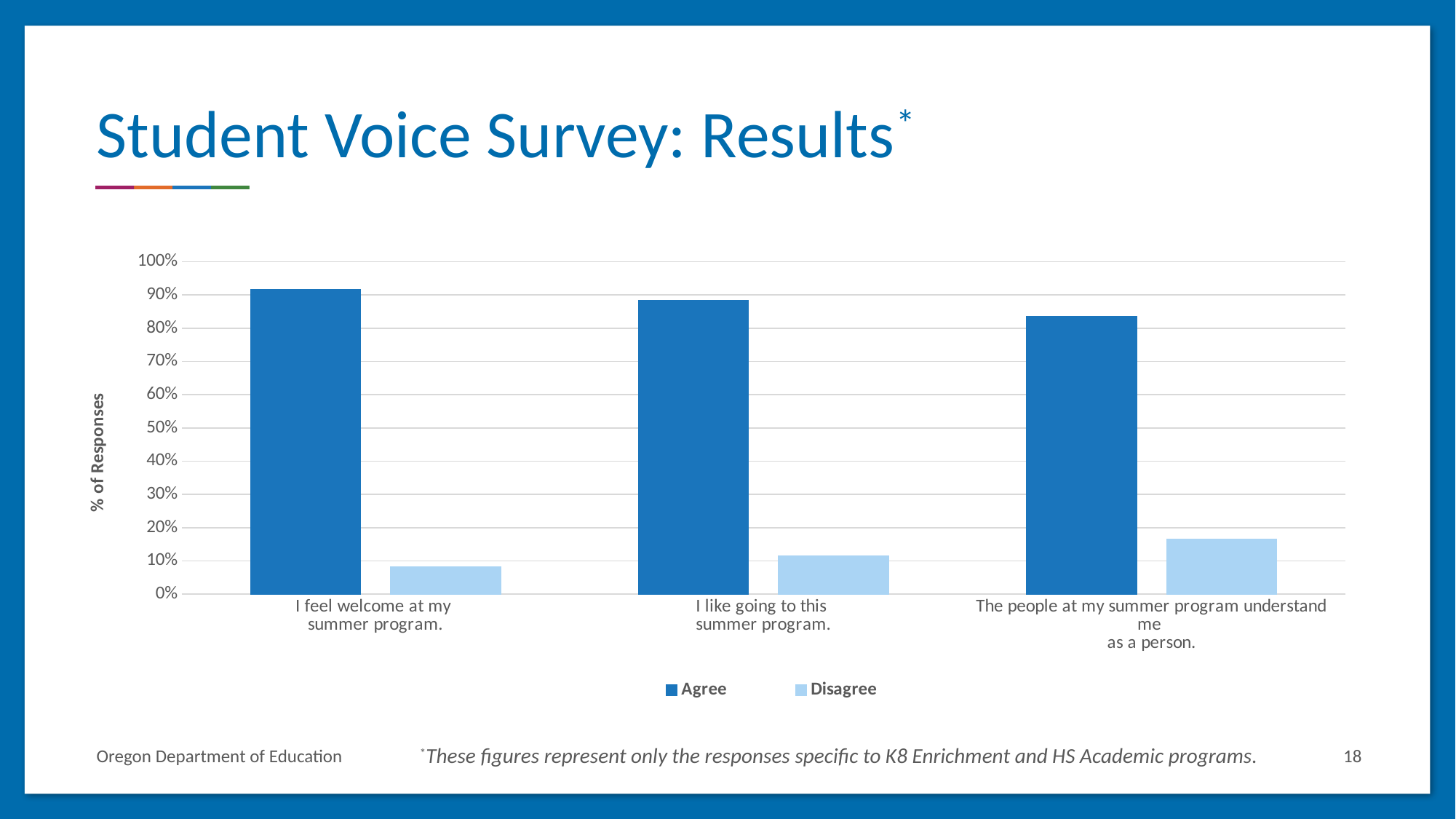
What kind of chart is shown on the slide? bar chart Which survey statement has the highest Disagree value? The people at my summer program understand me as a person. Is the Agree value for "The people at my summer program understand me as a person." greater or less than 90%? less Which survey statement has the highest Agree value? I feel welcome at my summer program. Do the Agree values rise or fall moving left to right across the x axis? fall What is the label on the vertical axis of the chart? % of Responses Which survey statement has the lowest Disagree value? I feel welcome at my summer program. Is the Agree value for "I feel welcome at my summer program." greater or less than 90%? greater How many series does the legend list? 2 How many survey statements (categories) are shown on the x axis? 3 Is the Disagree value for "I like going to this summer program." greater or less than 10%? greater Which survey statement has the lowest Agree value? The people at my summer program understand me as a person.